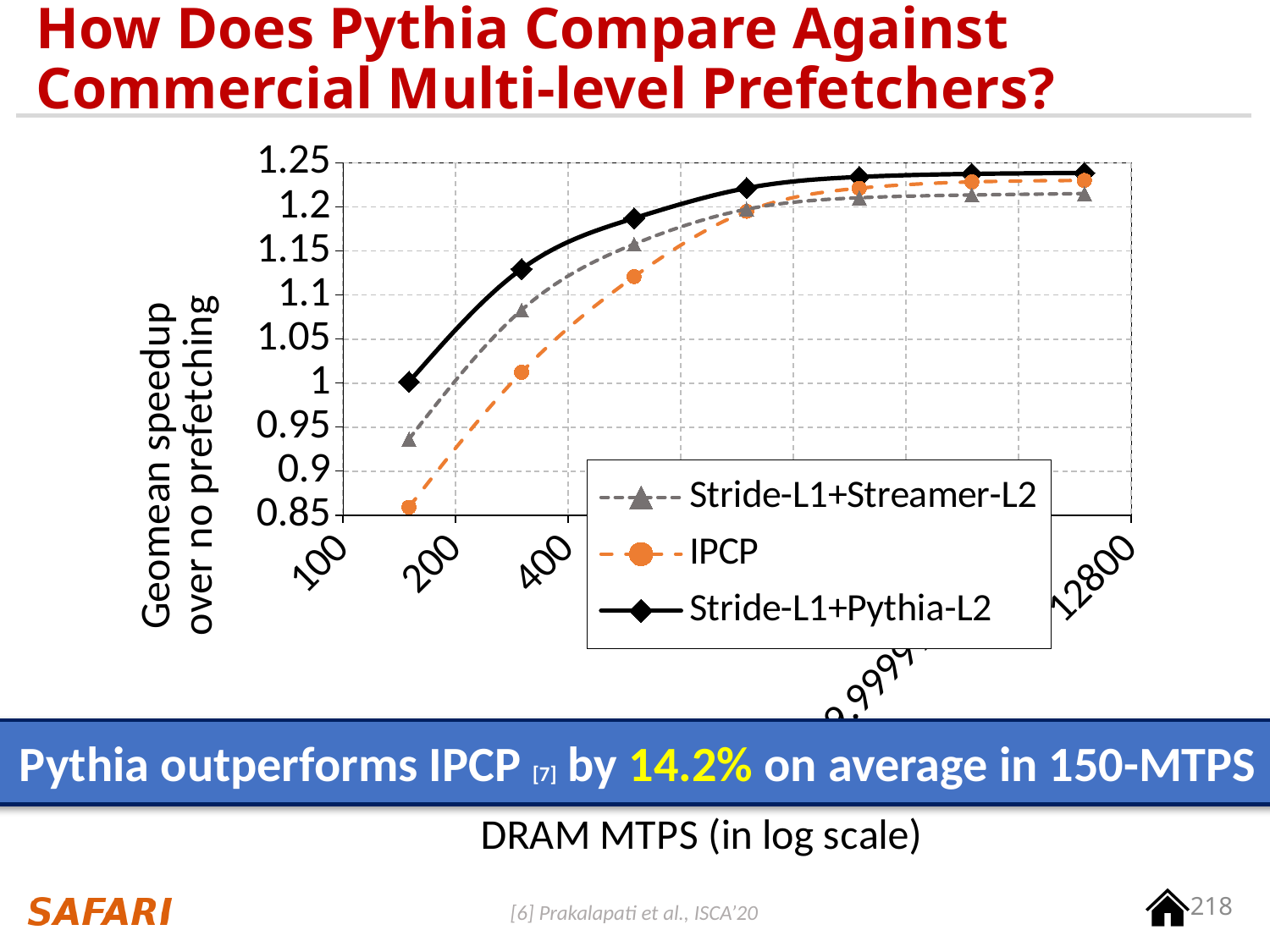
How many series does the legend list? 3 At the second data point from the left, which is higher: Stride-L1+Streamer-L2 or IPCP? Stride-L1+Streamer-L2 At the leftmost data point, which series has the highest value? Stride-L1+Pythia-L2 How many data points are plotted for the Stride-L1+Pythia-L2 series? 7 Do the values for Stride-L1+Pythia-L2 rise or fall as DRAM MTPS increases? rise What kind of chart is shown on the slide? line chart What is the title of the x axis? DRAM MTPS (in log scale) What is the title of the y axis? Geomean speedup over no prefetching Is the value for Stride-L1+Pythia-L2 at the rightmost data point greater or less than 1.2? greater Is the value for Stride-L1+Streamer-L2 at the leftmost data point greater or less than 1? less At the leftmost data point, which series has the lowest value? IPCP Is the value for IPCP at the leftmost data point greater or less than 0.9? less